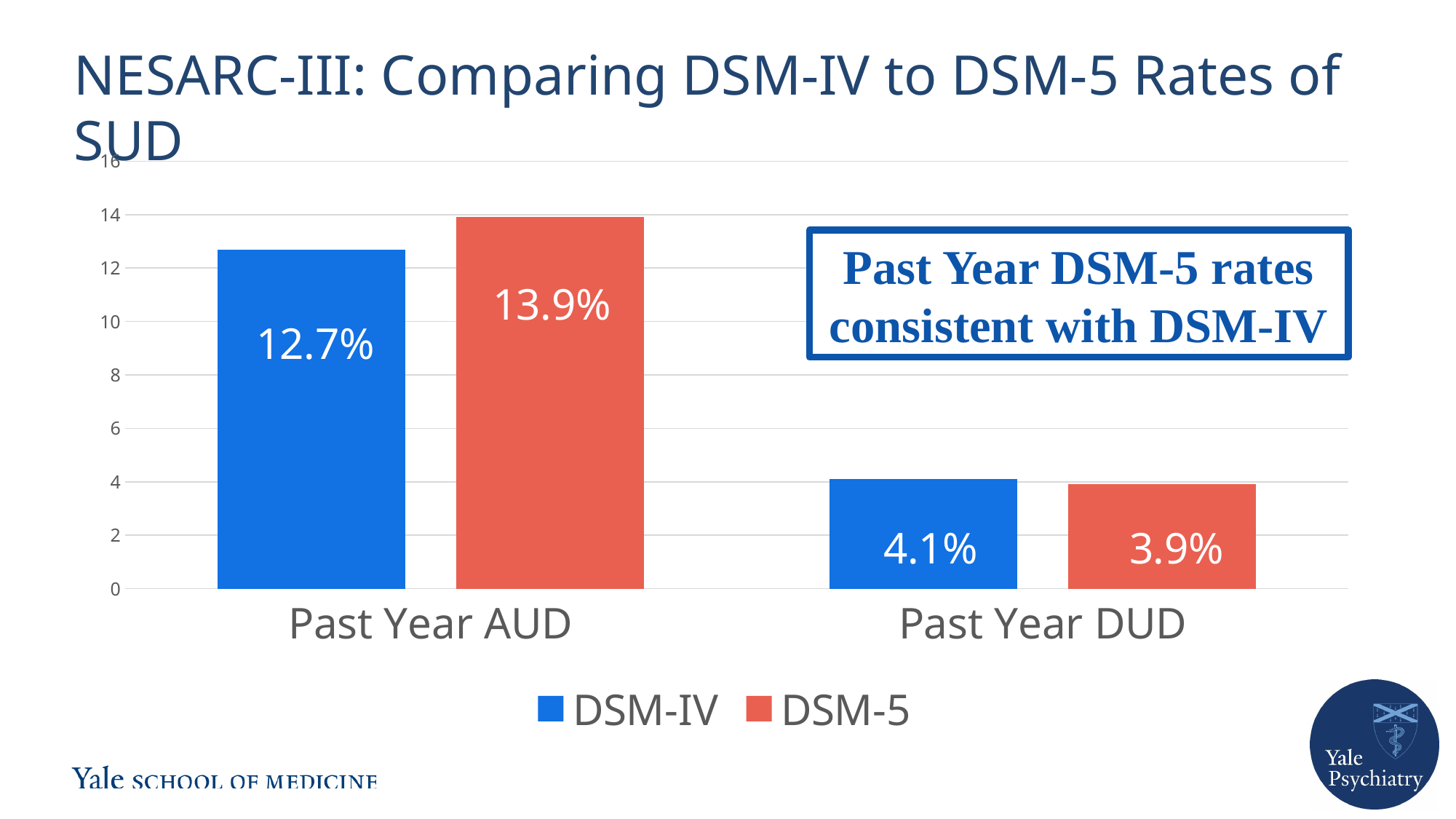
What is the difference between the DSM-5 and DSM-IV rates for Past Year AUD? 1.2% What is the DSM-IV rate for Past Year AUD? 12.7% How many categories are shown on the x axis? 2 For Past Year AUD, which is larger: the DSM-IV rate or the DSM-5 rate? DSM-5 How many series does the legend list? 2 Which bar shows the lowest value on the chart? DSM-5, Past Year DUD Which bar shows the highest value on the chart? DSM-5, Past Year AUD What kind of chart is shown on the slide? Bar chart What is the DSM-5 rate for Past Year DUD? 3.9% What is the DSM-5 rate for Past Year AUD? 13.9% What is the DSM-IV rate for Past Year DUD? 4.1% What is the difference between the DSM-IV and DSM-5 rates for Past Year DUD? 0.2%